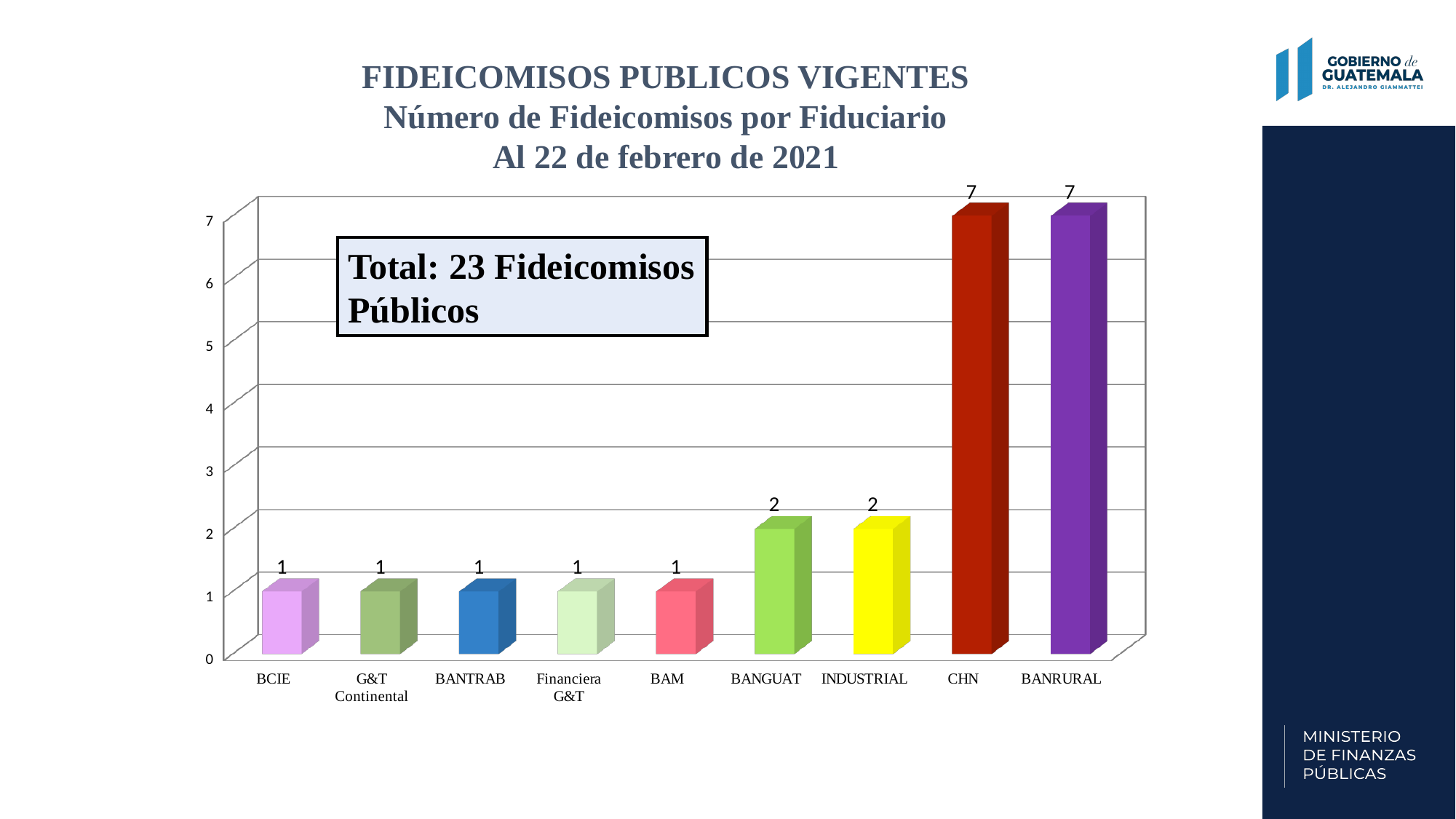
What is the value for BCIE? 1 Which categories have the highest value? CHN and BANRURAL What is the value for INDUSTRIAL? 2 How many categories are shown on the x axis? 9 What date does the chart title say the data is as of? 22 de febrero de 2021 What total is stated in the text box on the chart? 23 Fideicomisos Públicos Do the values generally rise or fall from left to right along the x axis? Rise Which is larger, the value for INDUSTRIAL or the value for BAM? INDUSTRIAL What kind of chart is shown on the slide? Bar chart What is the value for BANGUAT? 2 What is the difference between the values for BANRURAL and BANGUAT? 5 What is the value for CHN? 7